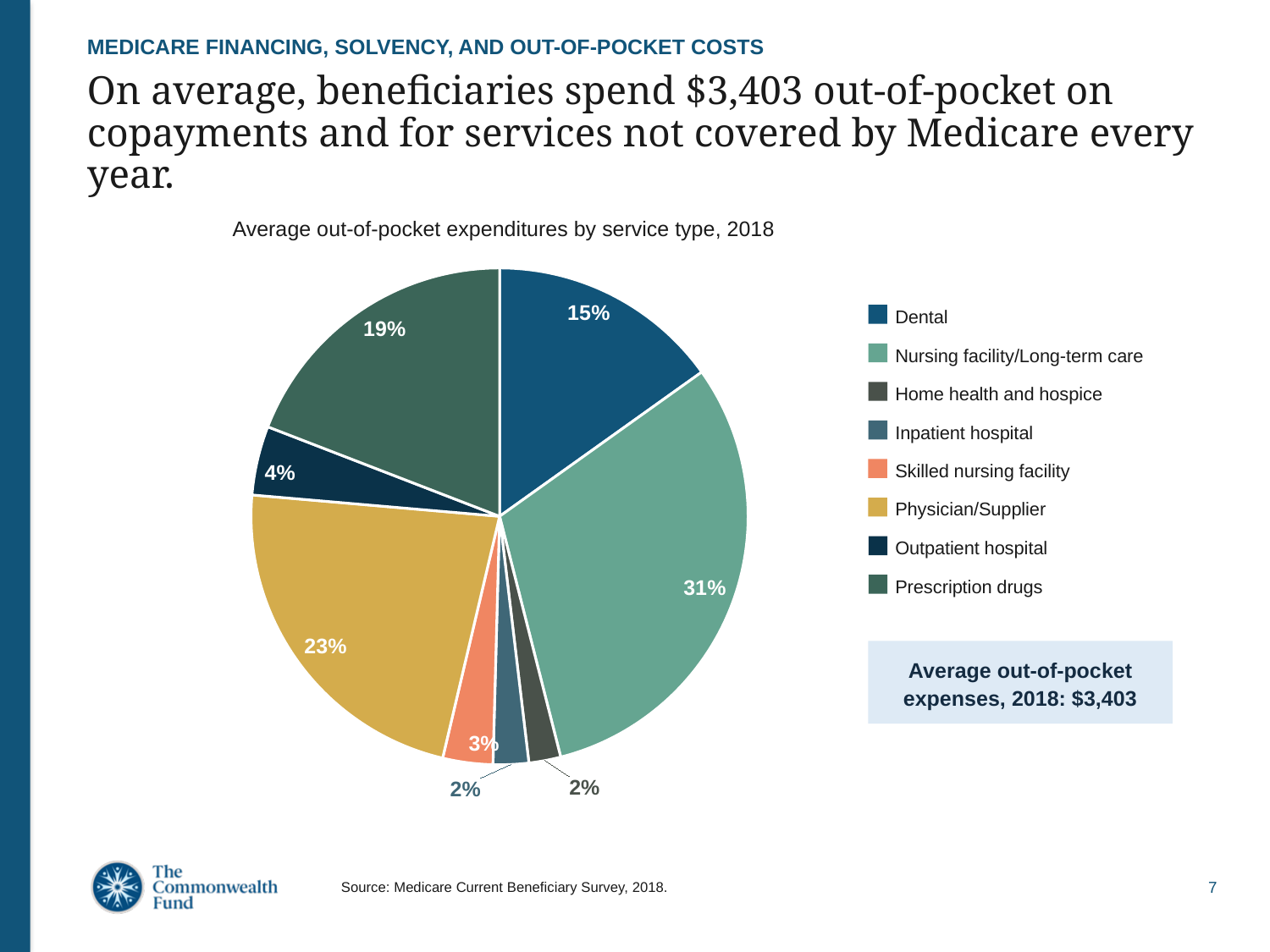
What is the difference in percentage points between the Physician/Supplier share and the Prescription drugs share? 4 percentage points What percentage of out-of-pocket expenditures is for Dental? 15% What is the title of the pie chart? Average out-of-pocket expenditures by service type, 2018 What percentage of out-of-pocket expenditures is for Physician/Supplier? 23% What share of out-of-pocket expenditures is for Outpatient hospital? 4% What share of out-of-pocket expenditures is for Prescription drugs? 19% What percentage of out-of-pocket expenditures is for Skilled nursing facility? 3% Which service type accounts for the largest share of out-of-pocket expenditures? Nursing facility/Long-term care What share of average out-of-pocket expenditures goes to Nursing facility/Long-term care? 31% How many service types are shown in the pie chart legend? 8 Which has a larger share of out-of-pocket expenditures, Dental or Prescription drugs? Prescription drugs What type of chart is shown on the slide? Pie chart